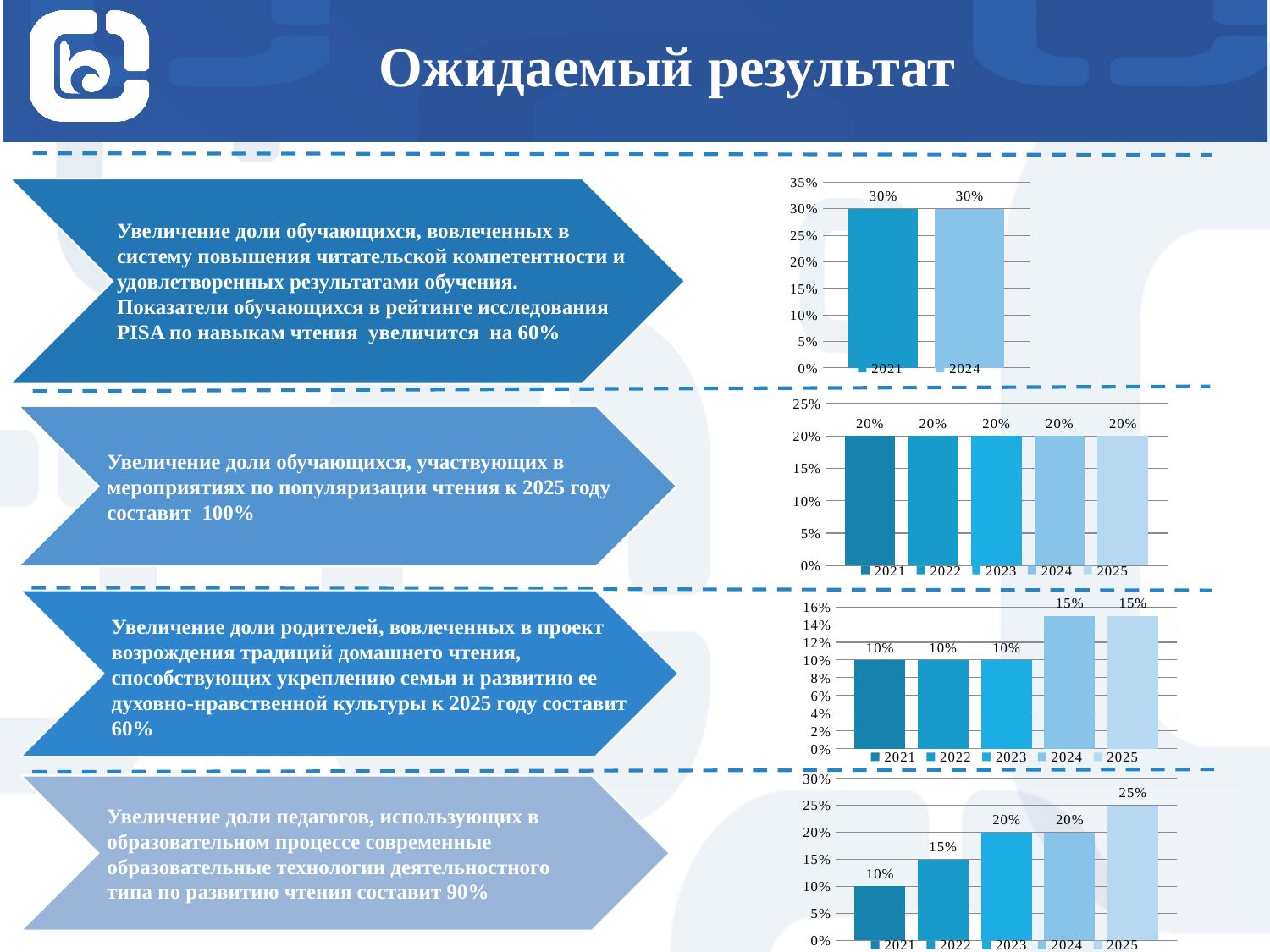
How many entries does the legend of the top chart list? 2 In the third chart from the top, what is the difference between the values for 2025 and 2021? 5% In the third chart from the top, what is the value for 2024? 15% What type of chart is the bottom chart on the slide? Bar chart In the top chart on the slide, what is the value for 2021? 30% In the bottom chart on the slide, what is the difference between the values for 2025 and 2021? 15% In the bottom chart on the slide, what is the value for 2022? 15% In the bottom chart on the slide, which year has the highest value? 2025 In the third chart from the top, which is larger, the value for 2023 or the value for 2025? 2025 In the bottom chart on the slide, what is the value for 2025? 25% How many bars are plotted in the second chart from the top? 5 In the bottom chart on the slide, which year has the lowest value? 2021